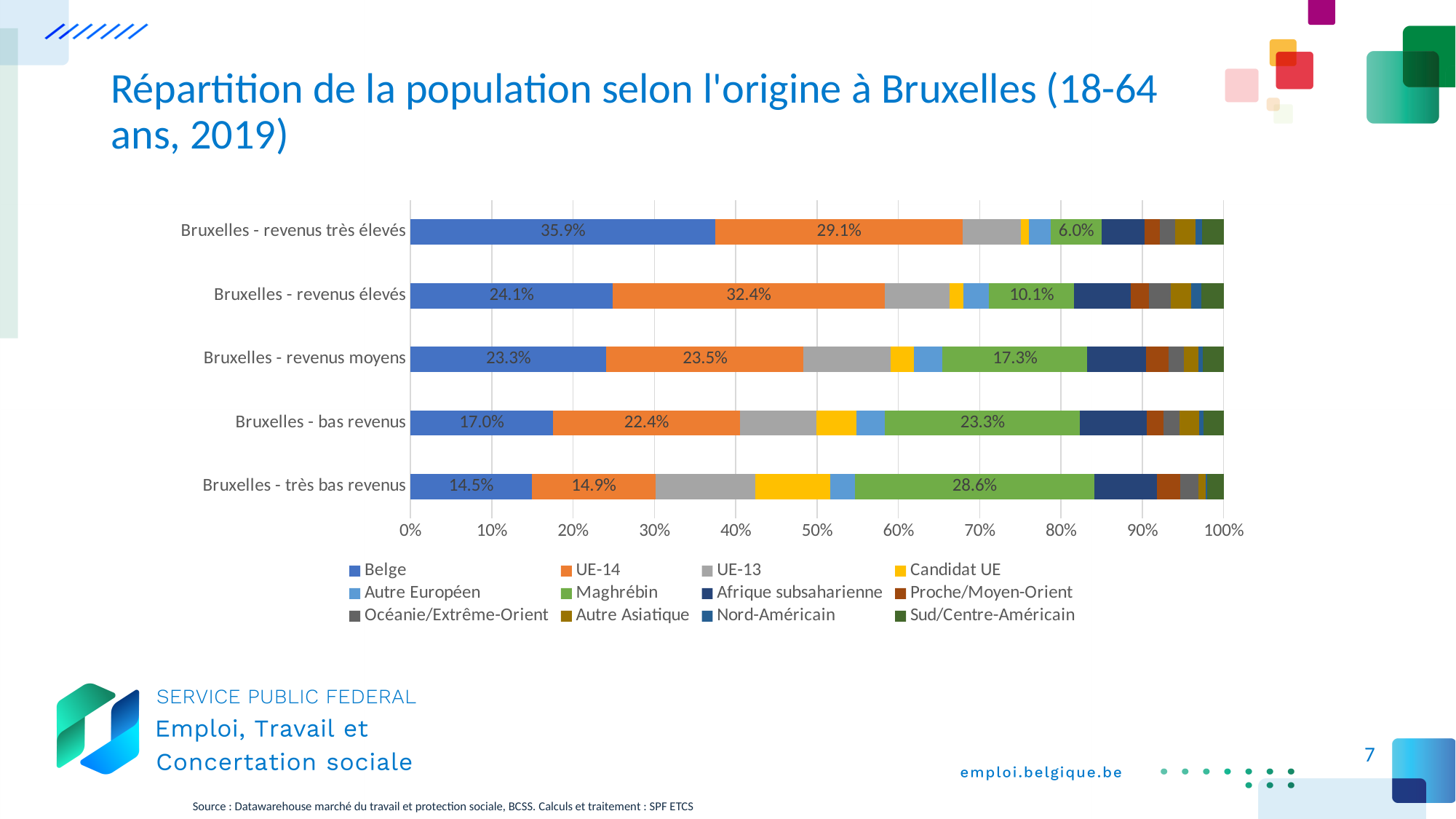
How many income categories are plotted on the chart? 5 What is the Maghrébin share for 'Bruxelles - très bas revenus'? 28.6% Which income category has the lowest Maghrébin share? Bruxelles - revenus très élevés What kind of chart is shown on the slide? Stacked bar chart What is the Belge share for 'Bruxelles - revenus très élevés'? 35.9% How many series does the legend list? 12 What is the difference between the Belge share for 'Bruxelles - revenus très élevés' and for 'Bruxelles - très bas revenus'? 21.4% What is the UE-14 share for 'Bruxelles - revenus élevés'? 32.4% Which legend entry is shown in orange? UE-14 Does the Belge share rise or fall as you move from 'Bruxelles - revenus très élevés' down to 'Bruxelles - très bas revenus'? Fall Which income category has the highest Belge share? Bruxelles - revenus très élevés Which is larger for 'Bruxelles - bas revenus': the Belge share or the Maghrébin share? Maghrébin